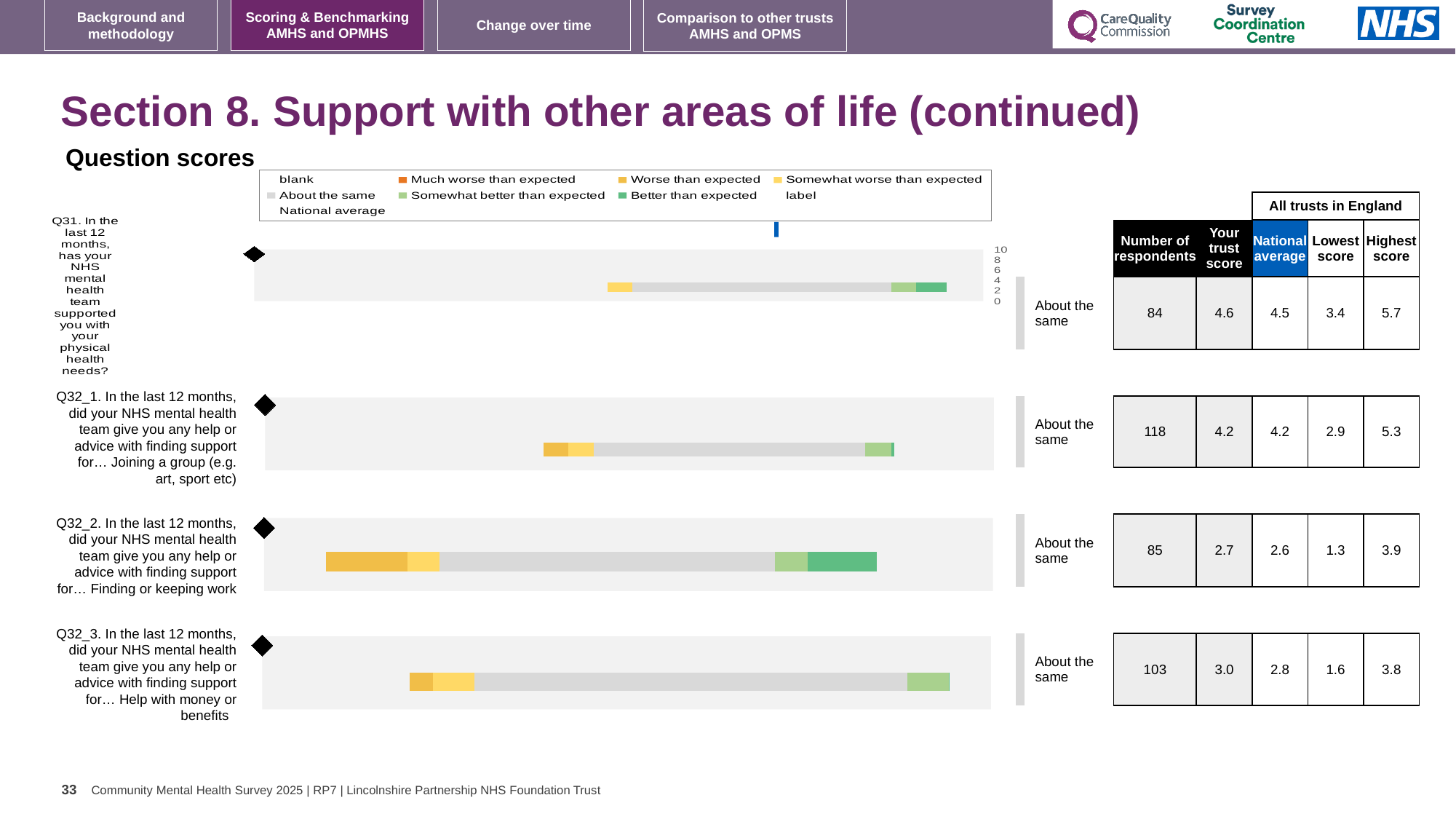
What is the lowest score among all trusts in England for Q32_1 (joining a group)? 2.9 How many questions (bars) are shown in the question scores chart? 4 Which question has the lowest 'Your trust score'? Q32_2 What is the 'Your trust score' value for Q31 (support with physical health needs)? 4.6 What benchmark category is shown next to each of the four question bars? About the same What kind of chart is used to show the question scores on this slide? Bar chart What is the national average for Q32_2 (finding or keeping work)? 2.6 Which question has the highest 'Your trust score'? Q31 How many respondents are recorded for Q32_3 (help with money or benefits)? 103 How many entries does the legend of the question scores chart list? 9 For Q31, which is larger: the trust score or the national average? Your trust score For Q32_3, what is the difference between the highest score and the lowest score among all trusts in England? 2.2